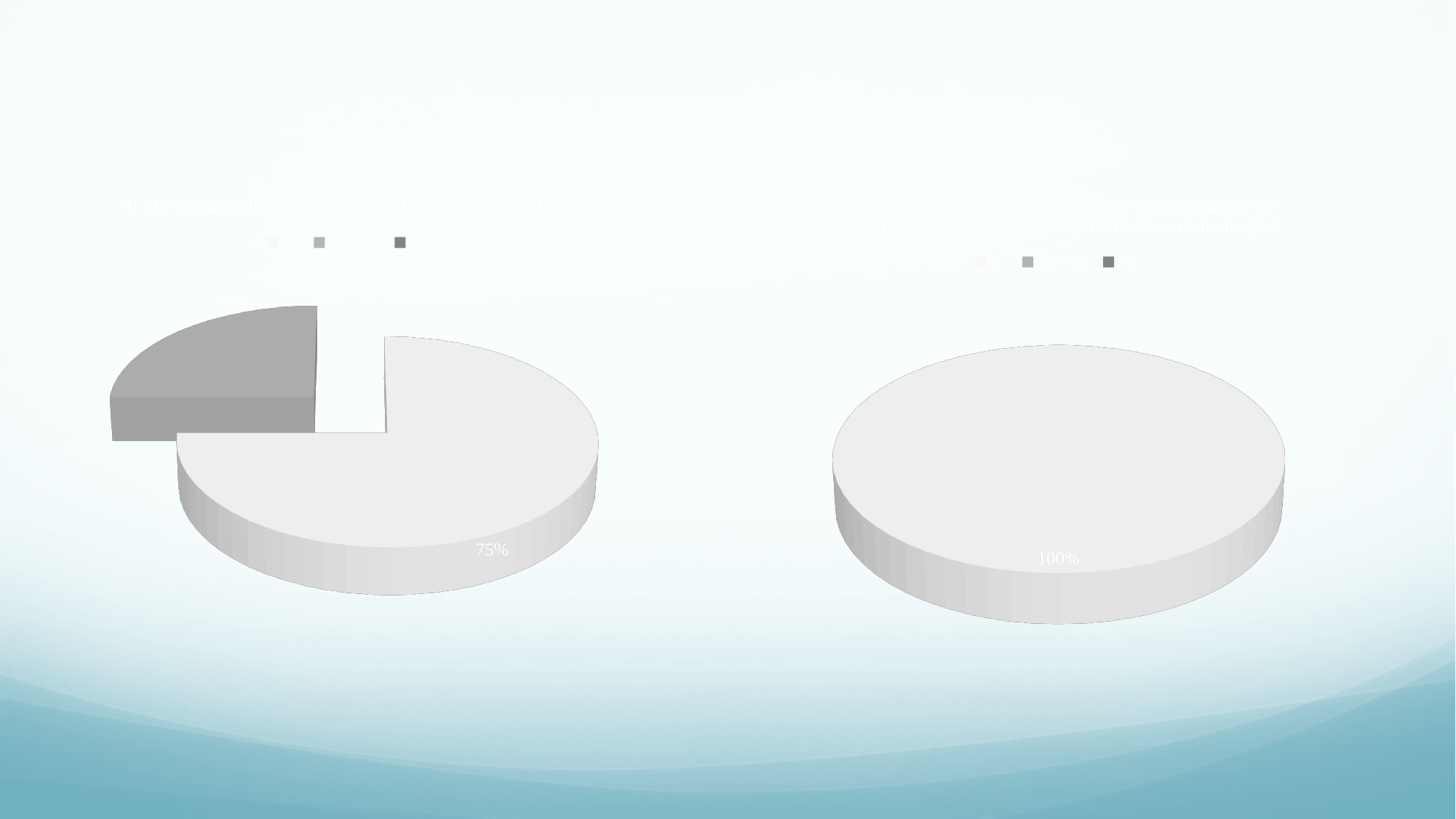
Is the smaller slice of the left pie chart greater or less than 50% of the pie? less What kind of chart is shown on the left side of the slide? pie chart How many entries does the legend of the right pie chart show? 3 How many slices are visible in the right pie chart? 1 In the left pie chart, what percentage is printed on the largest slice? 75% How many slices are visible in the left pie chart? 2 How many entries does the legend of the left pie chart show? 3 Which chart has the larger labelled slice, the left pie chart (75%) or the right pie chart (100%)? the right pie chart What kind of chart is shown on the right side of the slide? pie chart In the right pie chart, what percentage is printed on the pie? 100%